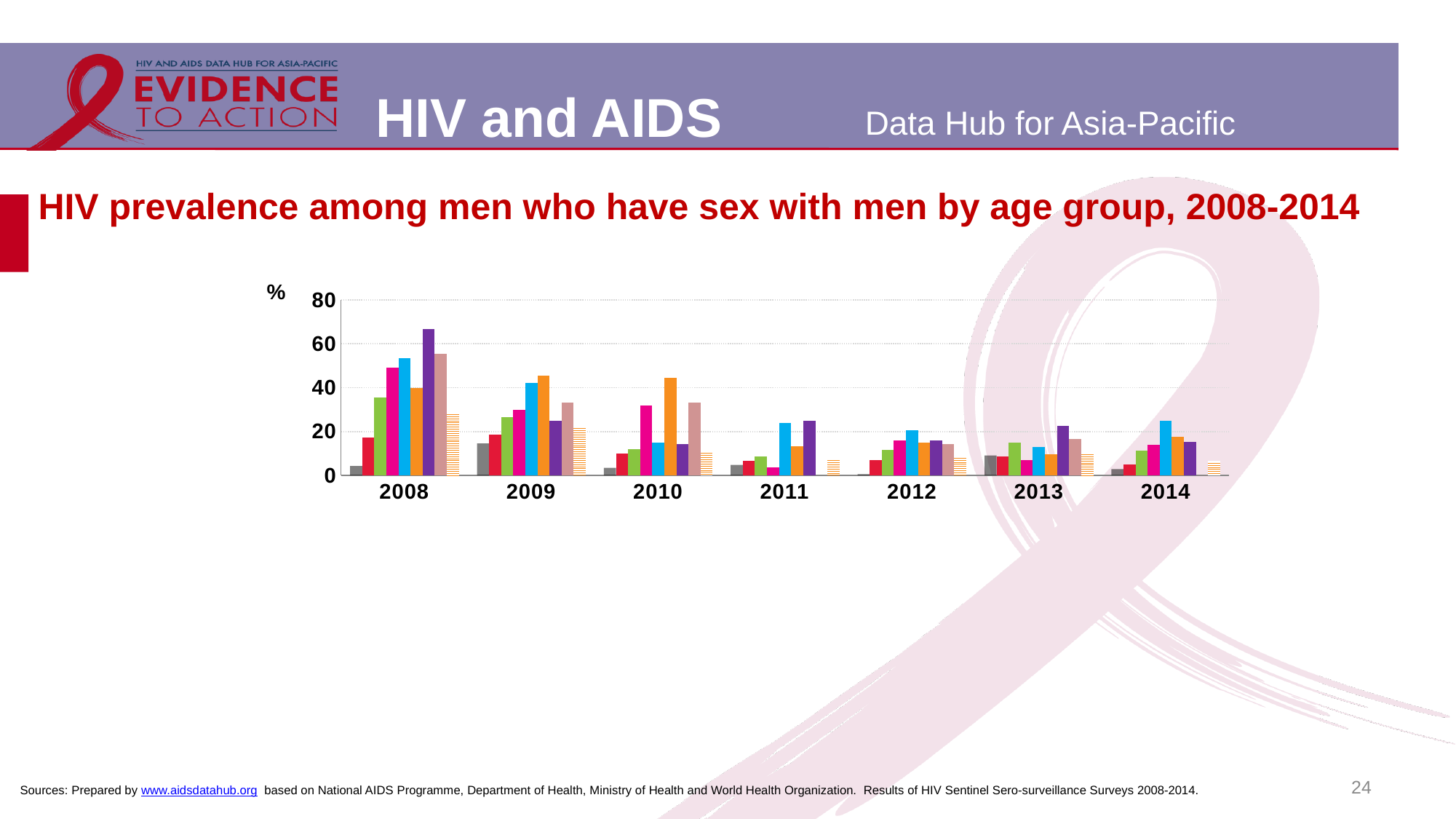
Do the tallest bars in each year generally rise or fall from 2008 to 2011? fall How many years are shown along the x axis of the chart? 7 Is the tallest bar in 2011 greater or less than 40? less How many bars are plotted for each year in the chart? 9 What kind of chart is shown on the slide? bar chart What is the last year shown on the x axis of the chart? 2014 What is the first year shown on the x axis of the chart? 2008 Is the tallest bar in 2010 greater or less than 40? greater What is the highest value labelled on the y axis of the chart? 80 In which year does the chart show its tallest bar? 2008 Which year has a taller tallest bar, 2009 or 2012? 2009 Is the tallest bar in 2008 greater or less than 60? greater